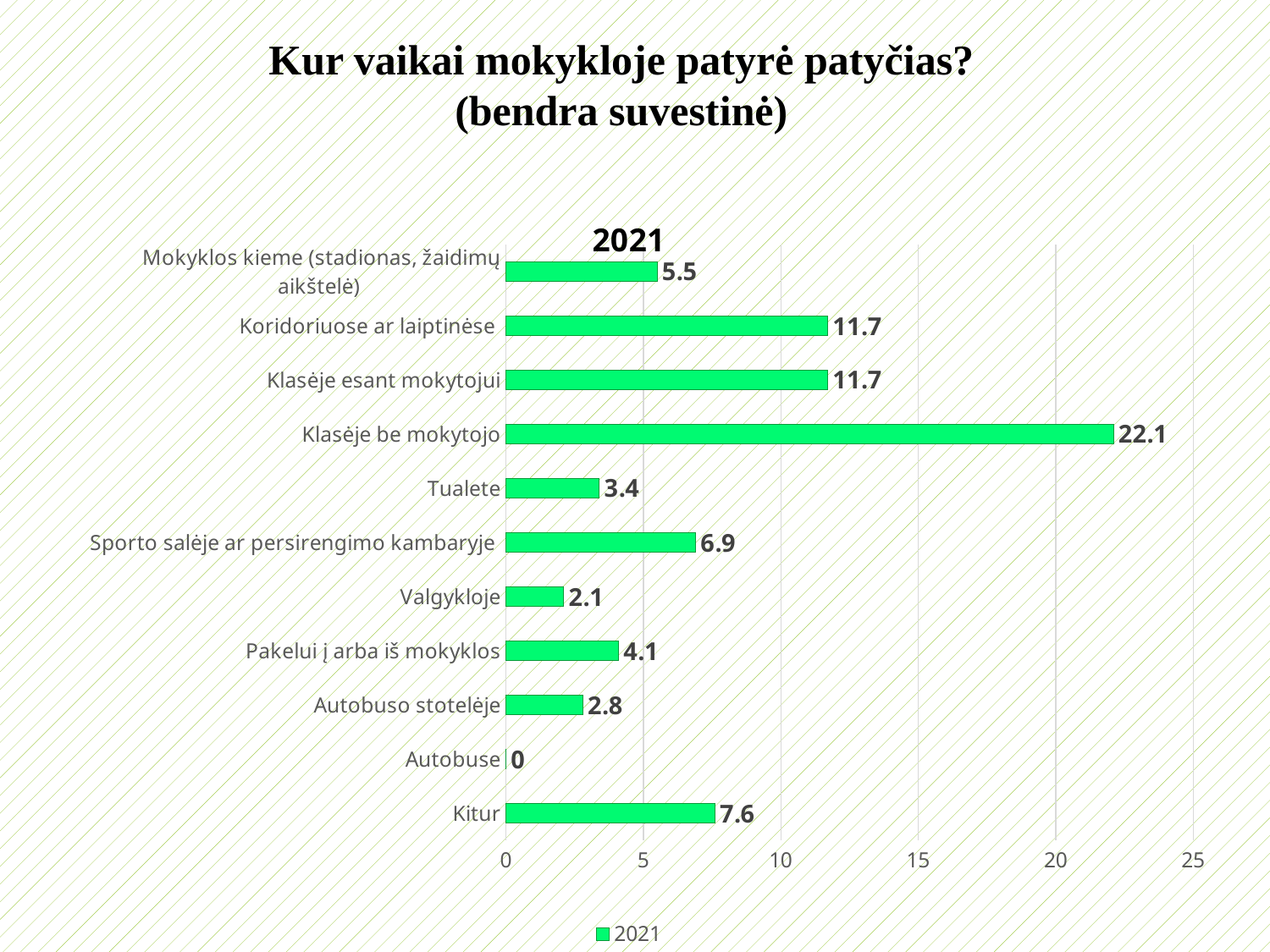
What is the value for Kitur? 7.6 Which category has the lowest value? Autobuse How many categories are shown in the chart? 11 What is the value for Klasėje be mokytojo? 22.1 What is the difference between the values for Klasėje be mokytojo and Koridoriuose ar laiptinėse? 10.4 What kind of chart is shown on the slide? bar chart What year does the legend entry show? 2021 What is the value for Tualete? 3.4 How many series does the legend list? 1 Is the value for Klasėje be mokytojo greater or less than 20? greater Which category has the highest value? Klasėje be mokytojo Which is larger, the value for Sporto salėje ar persirengimo kambaryje or the value for Pakelui į arba iš mokyklos? Sporto salėje ar persirengimo kambaryje